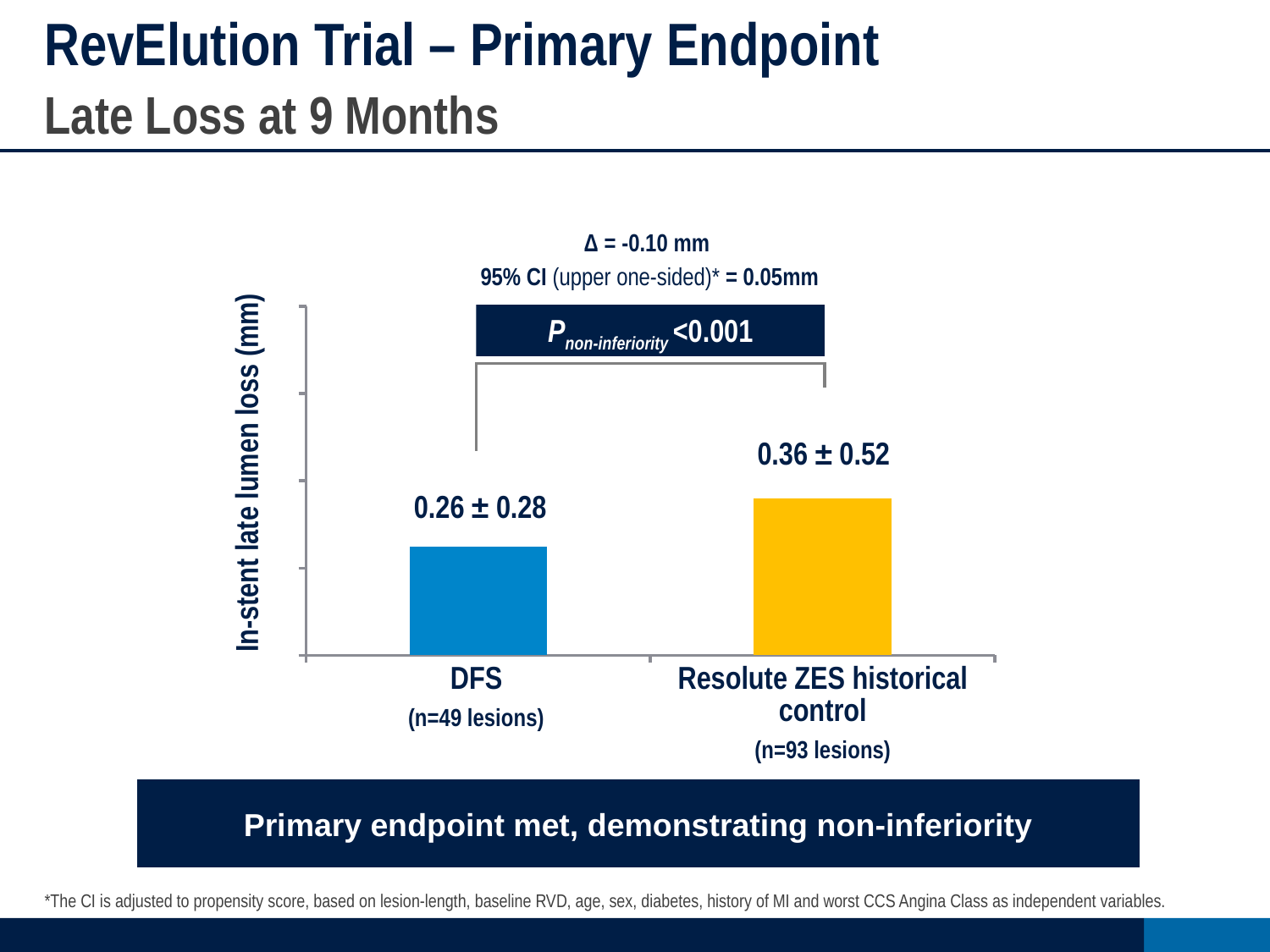
How many lesions are in the Resolute ZES historical control group? 93 What is the in-stent late lumen loss value shown for the Resolute ZES historical control? 0.36 ± 0.52 How many lesions are in the DFS group? 49 How many groups (bars) are plotted in the chart? 2 What is the P value for non-inferiority shown on the chart? <0.001 What is the label of the y-axis of the chart? In-stent late lumen loss (mm) Which group has the higher in-stent late lumen loss, DFS or Resolute ZES historical control? Resolute ZES historical control What is the in-stent late lumen loss value shown for DFS? 0.26 ± 0.28 What type of chart is shown on the slide? Bar chart Which group has the lowest in-stent late lumen loss? DFS Which group has the highest in-stent late lumen loss? Resolute ZES historical control What is the difference (Δ) in late lumen loss between DFS and the Resolute ZES historical control, as printed on the slide? -0.10 mm